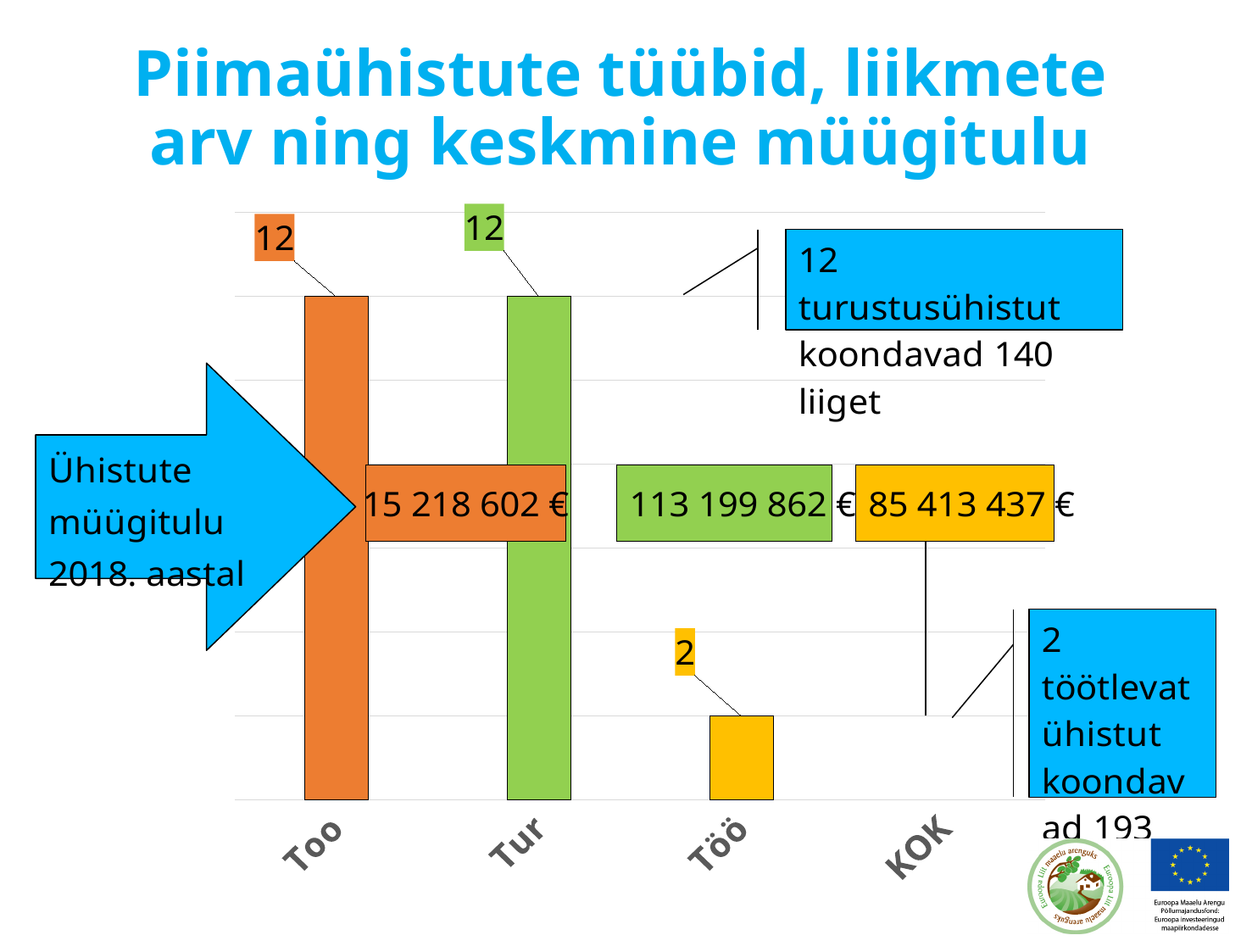
What sales revenue figure is shown in the orange box over the chart? 15 218 602 € What is the difference between the values for Tur and Töö? 10 What is the value shown for Töö? 2 What kind of chart is shown on the slide? bar chart What is the value shown for Tur? 12 How many categories are labelled on the x axis? 4 What is the value shown for Too? 12 Which is larger, the value for Too or the value for Töö? Too What sales revenue figure is shown in the green box over the chart? 113 199 862 € What is the title of the slide? Piimaühistute tüübid, liikmete arv ning keskmine müügitulu What sales revenue figure is shown in the yellow box over the chart? 85 413 437 € What colour is the bar for Töö? yellow